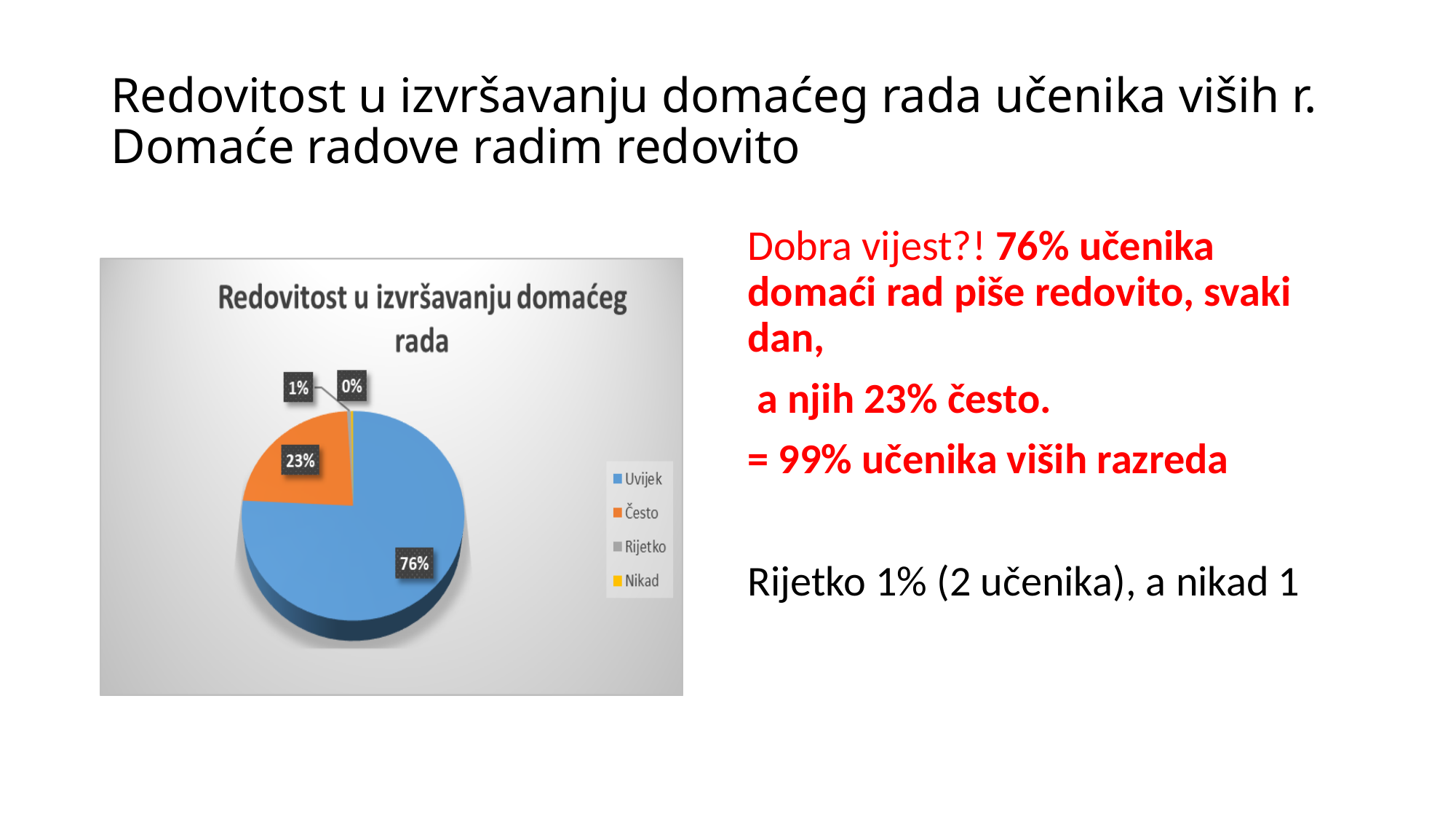
What percentage is shown for the Nikad slice? 0% What percentage is shown for the Uvijek slice? 76% What is the chart's title? Redovitost u izvršavanju domaćeg rada What colour is the Često slice? orange What percentage is shown for the Često slice? 23% What kind of chart is shown on the slide? pie chart What percentage is shown for the Rijetko slice? 1% Which category has the largest slice of the pie? Uvijek What is the difference in percentage points between the Uvijek and Često slices? 53 Which category has the smallest slice of the pie? Nikad Which slice is larger, Često or Rijetko? Često How many categories does the legend list? 4